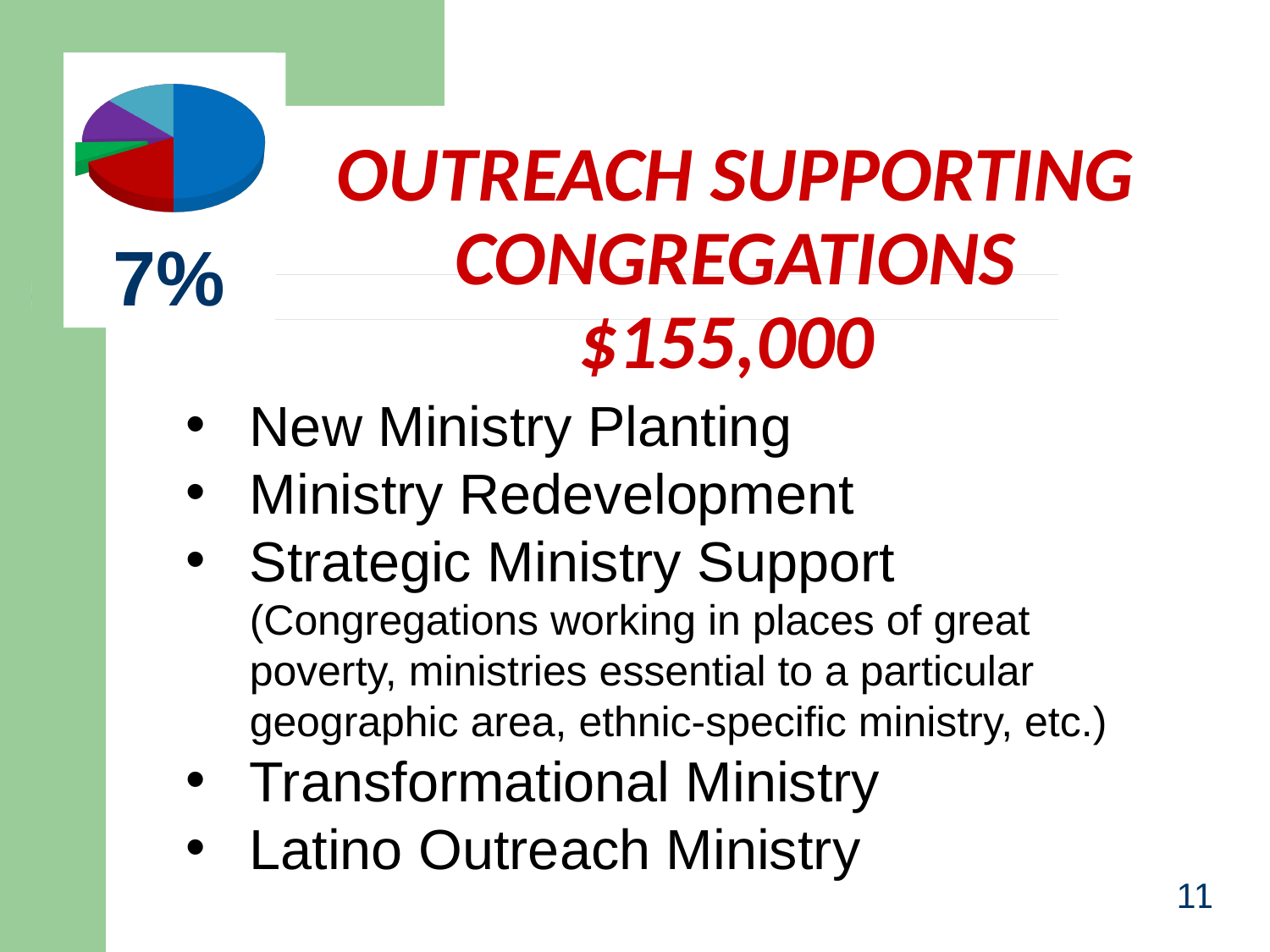
Does the pie chart display a legend? No What percentage is printed beside the pie chart? 7% Is the blue slice of the pie chart larger or smaller than the red slice? larger What kind of chart is shown in the top-left corner of the slide? pie chart Which colour slice of the pie chart is the largest? blue How many slices does the pie chart have? 5 Is the share shown beside the pie chart greater or less than 10%? less Which colour slice is pulled out (exploded) from the pie chart? green